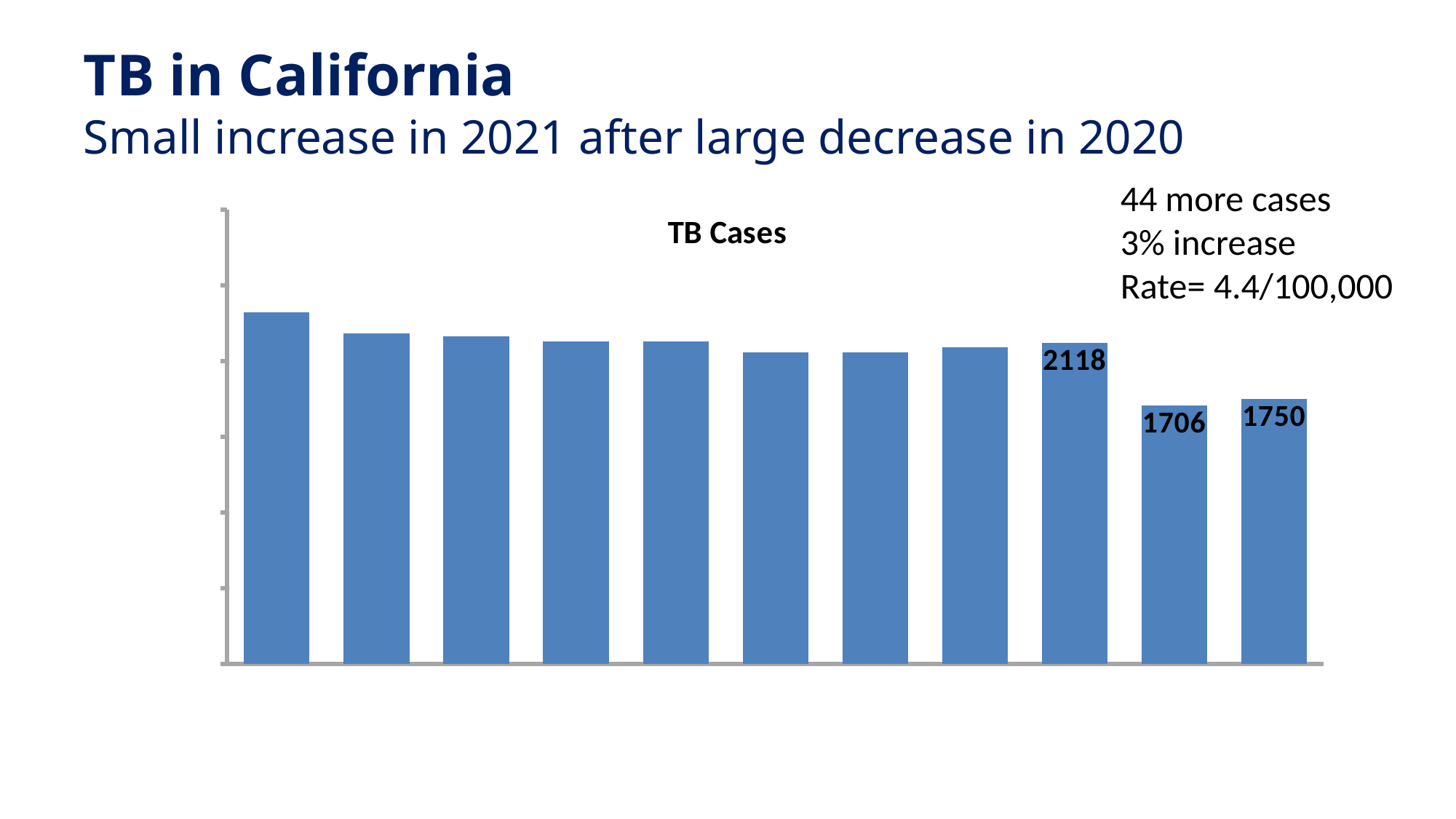
What value is labelled on the last (rightmost) bar of the chart? 1750 What value is labelled on the third-to-last bar of the chart? 2118 What kind of chart is shown on the slide? bar chart How many bars are plotted in the chart? 11 What value is labelled on the second-to-last bar of the chart? 1706 Which bar in the chart is the lowest? the second-to-last bar (1706) What is the difference between the last bar (1750) and the second-to-last bar (1706)? 44 Do the bar values generally rise or fall from left to right across the chart? fall What is the difference between the third-to-last bar (2118) and the second-to-last bar (1706)? 412 What is the title of the chart? TB Cases Which bar in the chart is the tallest? the first (leftmost) bar Which is larger, the value of the last bar or the value of the second-to-last bar? the last bar (1750)